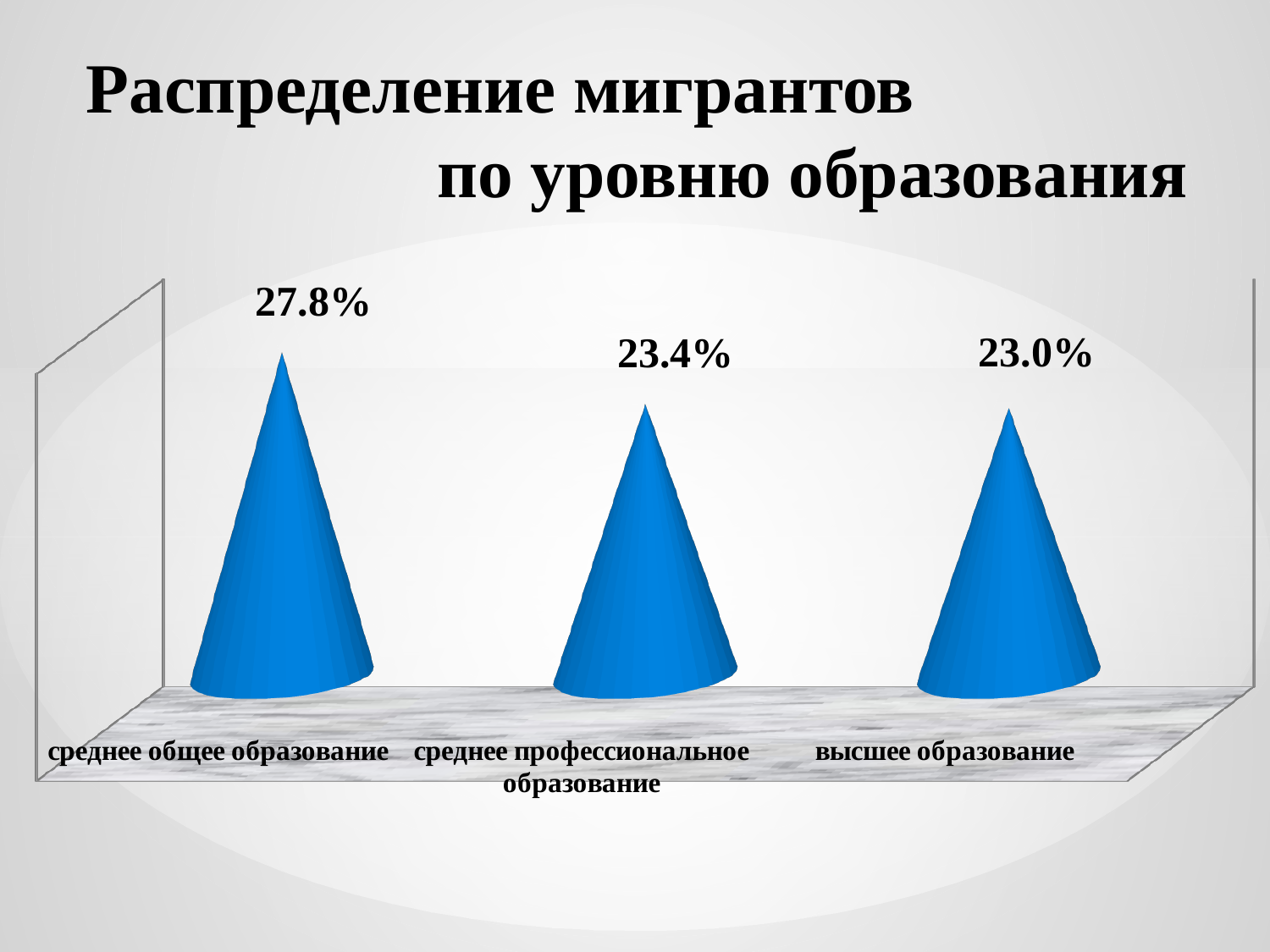
How many categories are shown in the chart? 3 What is the title of the chart on the slide? Распределение мигрантов по уровню образования Which education level has the lowest share of migrants? высшее образование What is the difference between the values for среднее общее образование and высшее образование? 4.8% What is the value for среднее профессиональное образование? 23.4% Which is larger: the value for среднее общее образование or the value for среднее профессиональное образование? среднее общее образование What is the difference between the values for среднее профессиональное образование and высшее образование? 0.4% What is the value for высшее образование? 23.0% Do the values rise or fall from left to right across the categories? fall Which education level has the highest share of migrants? среднее общее образование What kind of chart is shown on the slide? bar chart What is the value for среднее общее образование? 27.8%